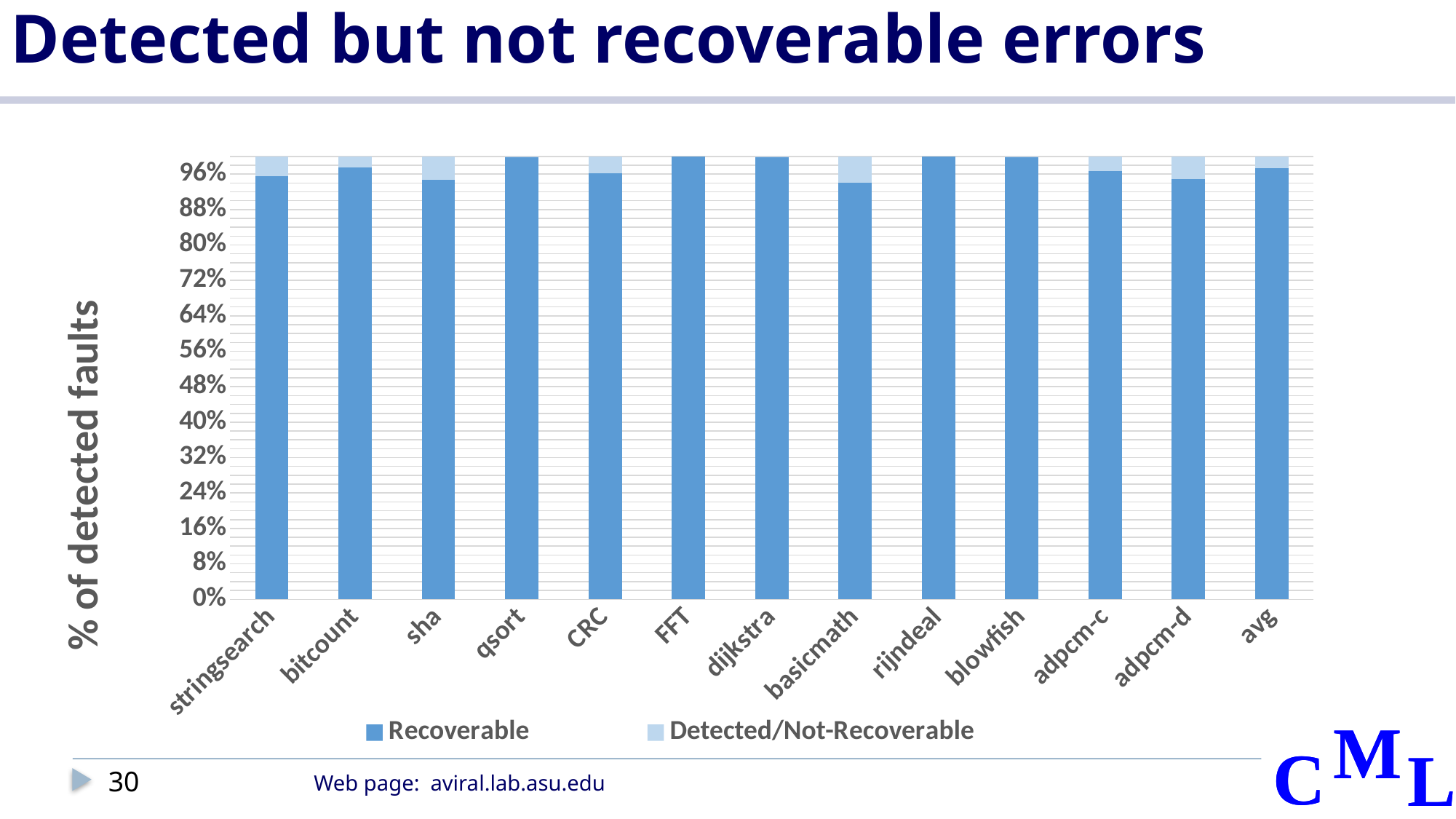
What is the label on the y axis of the chart? % of detected faults Is the Recoverable value for avg greater or less than 88%? greater Is the Recoverable value for sha greater or less than 96%? less Which has the larger Recoverable value, qsort or basicmath? qsort Is the Recoverable value for stringsearch greater or less than 88%? greater How many categories are shown along the x axis of the chart? 13 What are the two series named in the chart's legend? Recoverable and Detected/Not-Recoverable How many series does the chart's legend list? 2 Which has the larger Detected/Not-Recoverable value, basicmath or FFT? basicmath Which has the larger Recoverable value, bitcount or sha? bitcount What kind of chart is shown on the slide? bar chart